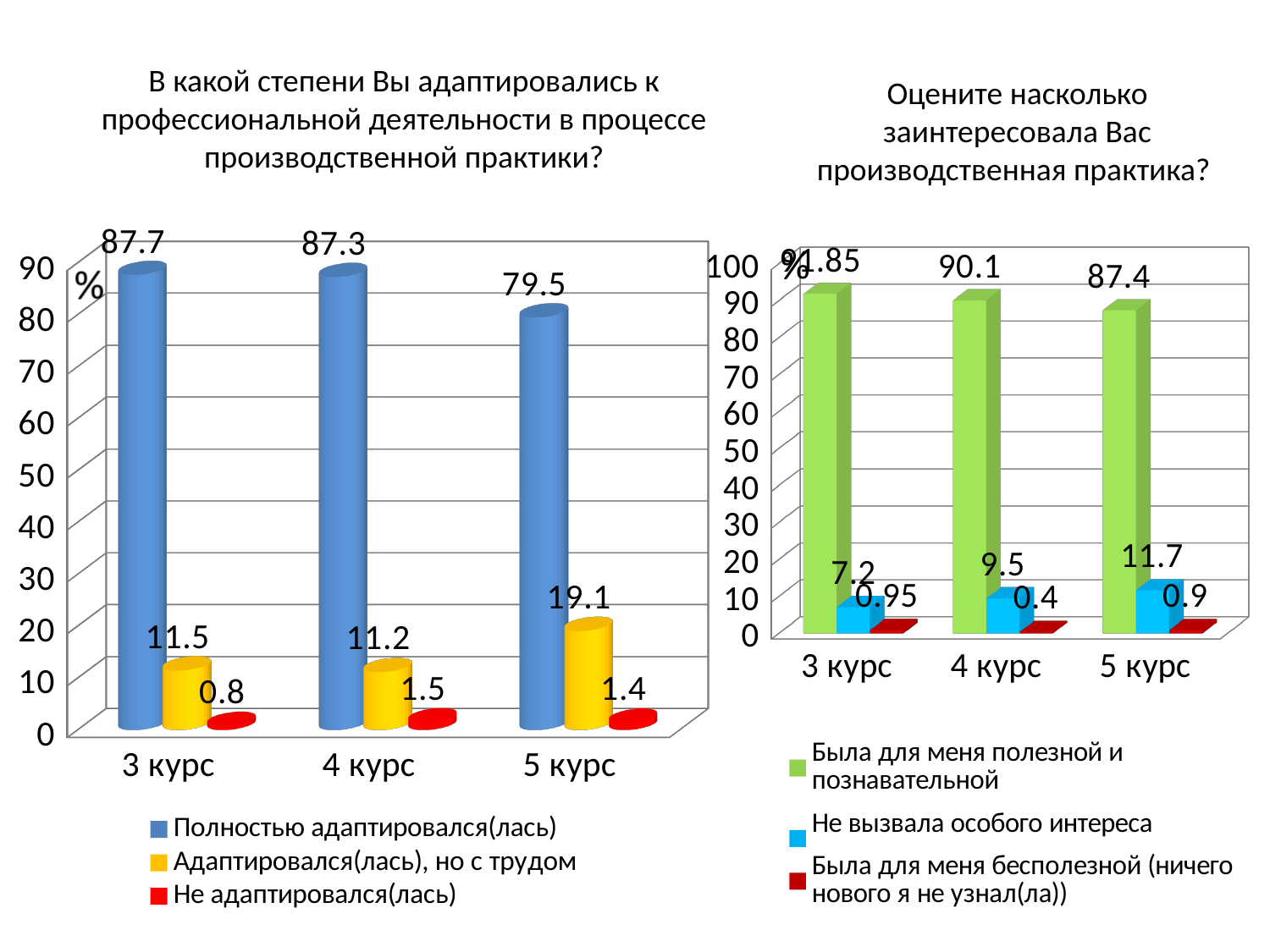
In the right chart, which course has the highest value for "Не вызвала особого интереса"? 5 курс In the left chart, which course has the lowest value for "Полностью адаптировался(лась)"? 5 курс In the left chart ("В какой степени Вы адаптировались..."), what is the value for "Полностью адаптировался(лась)" for 3 курс? 87.7 In the right chart, what is the value for "Была для меня бесполезной" for 3 курс? 0.95 In the left chart, what is the value for "Адаптировался(лась), но с трудом" for 5 курс? 19.1 In the left chart, what is the difference between the "Адаптировался(лась), но с трудом" values for 5 курс and 3 курс? 7.6 In the right chart, what is the value for "Не вызвала особого интереса" for 5 курс? 11.7 In the right chart, does the value for "Была для меня полезной и познавательной" rise or fall from 3 курс to 5 курс? fall In the left chart, what is the value for "Не адаптировался(лась)" for 4 курс? 1.5 In the right chart ("Оцените насколько заинтересовала Вас производственная практика?"), what is the value for "Была для меня полезной и познавательной" for 4 курс? 90.1 What kind of chart is the right chart? bar chart In the left chart, how many series does the legend list? 3